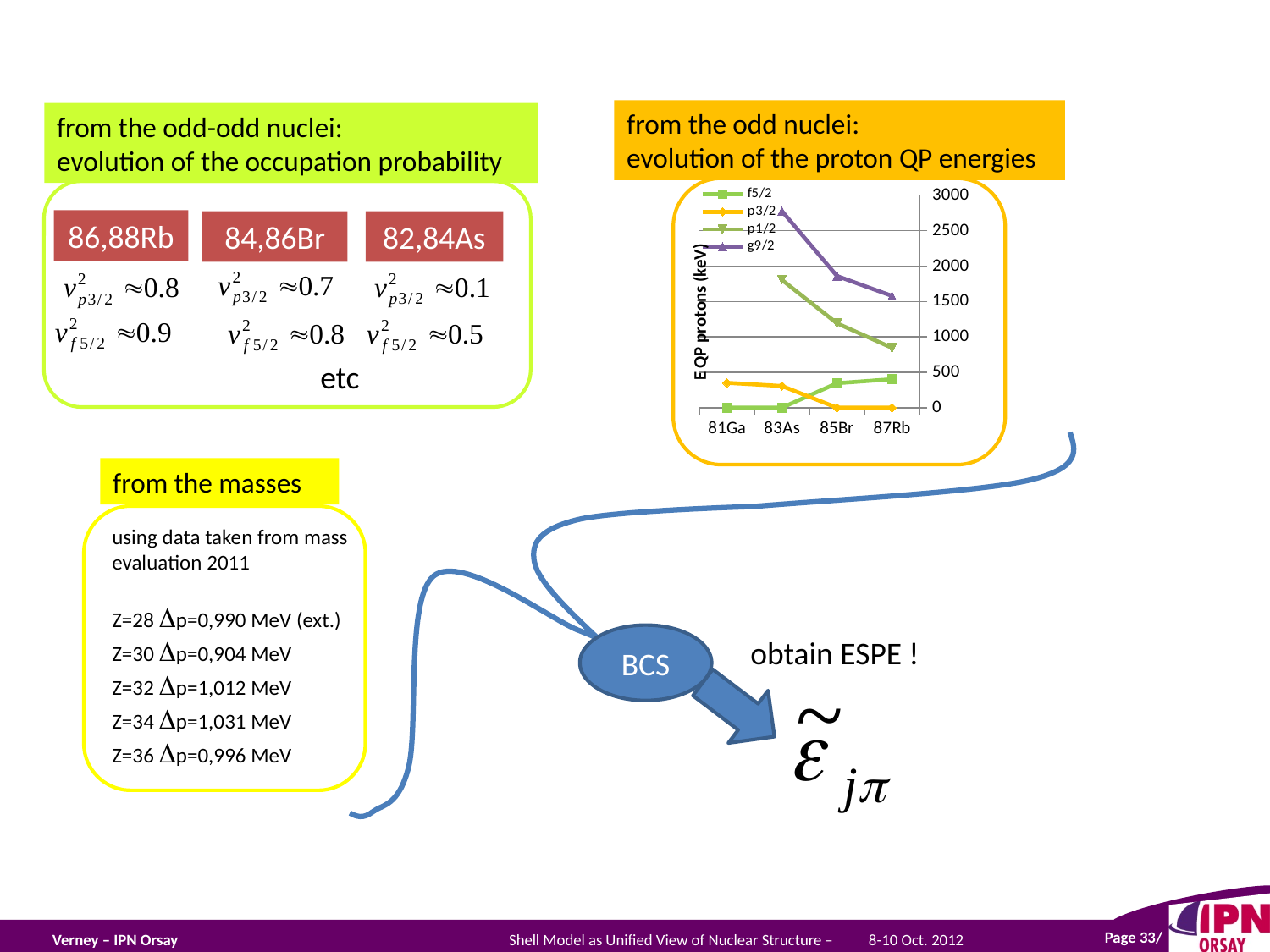
What kind of chart is shown on the slide? line chart How many categories are shown on the x axis of the chart? 4 Is the value of g9/2 at 87Rb greater or less than 1000? greater Does the p1/2 series rise or fall from 83As to 87Rb? fall Which is larger at 85Br, the value of g9/2 or the value of p1/2? g9/2 Which is larger at 81Ga, the value of p3/2 or the value of f5/2? p3/2 Which series has the highest value at 83As? g9/2 Is the value of g9/2 at 83As greater or less than 2500? greater Is the value of p1/2 at 87Rb greater or less than 1000? less How many series does the chart legend list? 4 What is the label of the y axis of the chart? E QP protons (keV) Does the g9/2 series rise or fall from 83As to 87Rb? fall